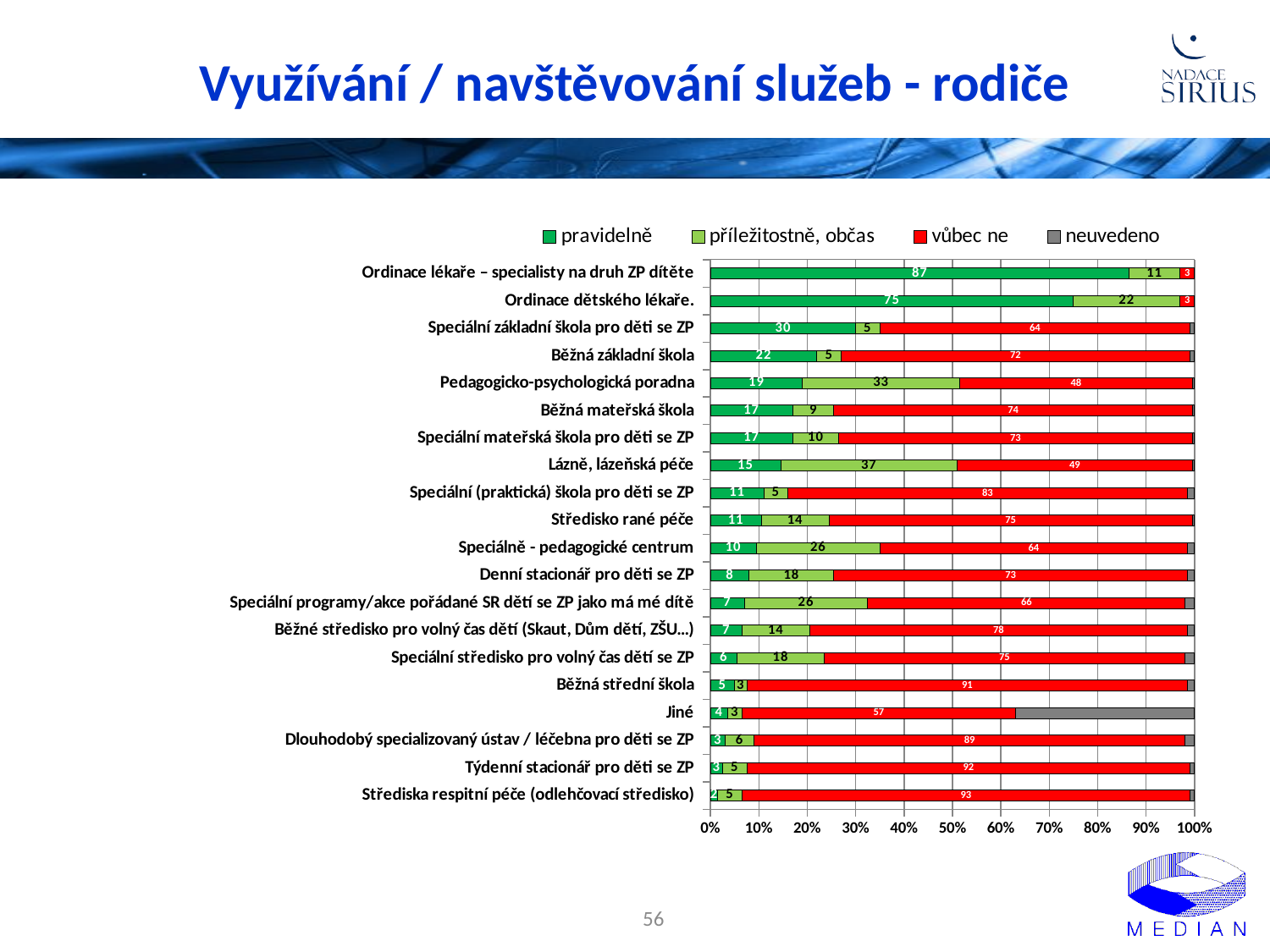
Which is larger: the 'příležitostně, občas' value for 'Speciálně - pedagogické centrum' or for 'Středisko rané péče'? Speciálně - pedagogické centrum How many categories (services) are plotted in the chart? 20 Which category has the highest 'pravidelně' value? Ordinace lékaře – specialisty na druh ZP dítěte What is the 'příležitostně, občas' value for 'Lázně, lázeňská péče'? 37 What is the difference between the 'pravidelně' values for 'Ordinace lékaře – specialisty na druh ZP dítěte' and 'Ordinace dětského lékaře.'? 12 What is the 'vůbec ne' value for 'Běžná střední škola'? 91 How many series does the legend list? 4 What is the 'pravidelně' value for 'Ordinace dětského lékaře.'? 75 What type of chart is shown on the slide? stacked bar chart Which series is shown in red in the legend? vůbec ne What is the 'vůbec ne' value for 'Jiné'? 57 Which category has the lowest 'pravidelně' value? Střediska respitní péče (odlehčovací středisko)